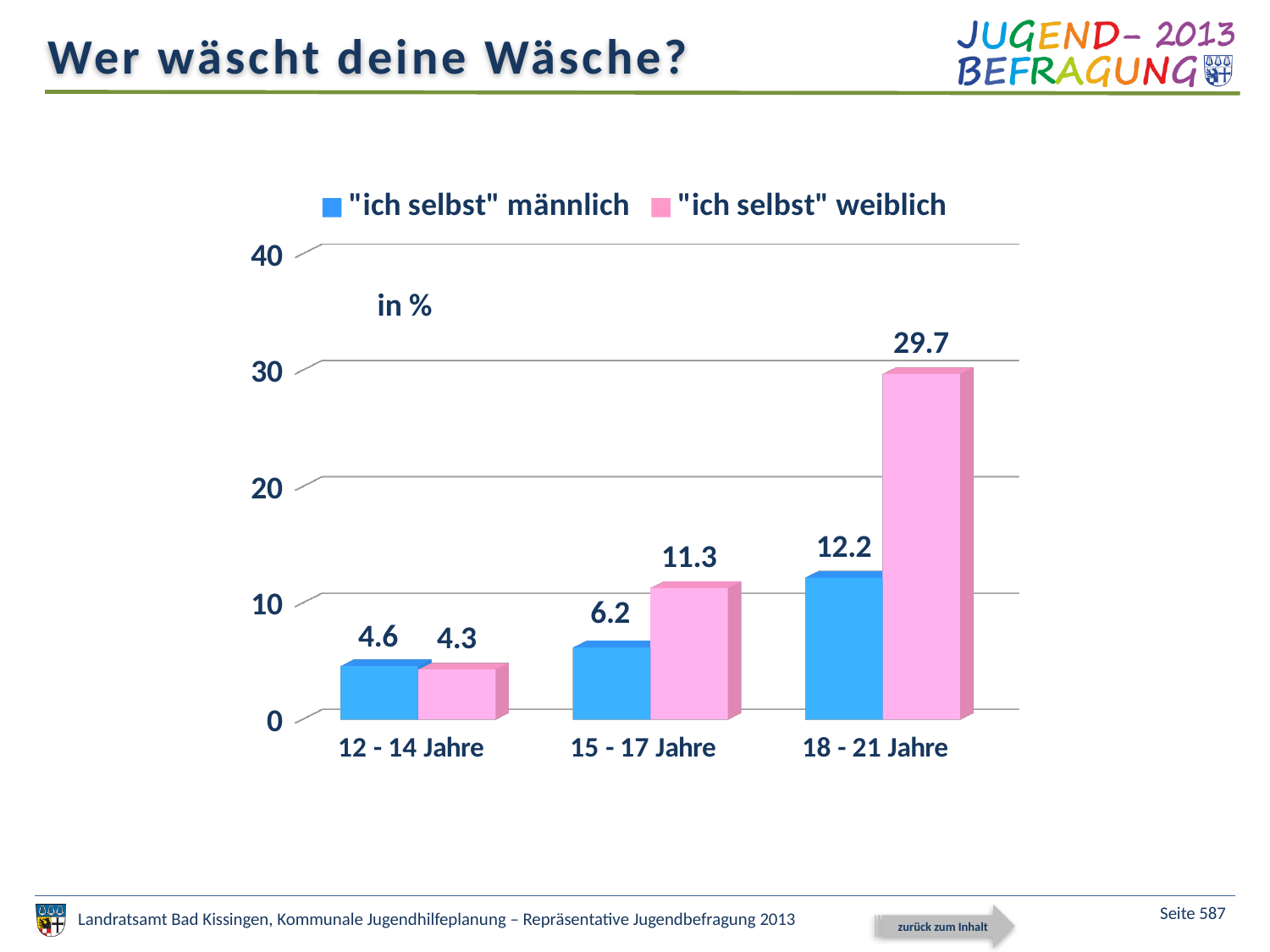
How many age groups are shown on the x axis? 3 What kind of chart is shown on the slide? bar chart How many series does the legend list? 2 Which age group has the highest value for "ich selbst" weiblich? 18 - 21 Jahre What is the value for "ich selbst" weiblich in the 15 - 17 Jahre group? 11.3 In the 15 - 17 Jahre group, which is larger: "ich selbst" männlich or "ich selbst" weiblich? "ich selbst" weiblich Which age group has the lowest value for "ich selbst" männlich? 12 - 14 Jahre What is the value for "ich selbst" weiblich in the 18 - 21 Jahre group? 29.7 Is the value for "ich selbst" männlich in the 18 - 21 Jahre group greater or less than 10? greater What is the value for "ich selbst" männlich in the 12 - 14 Jahre group? 4.6 Do the values for "ich selbst" männlich rise or fall from the 12 - 14 Jahre group to the 18 - 21 Jahre group? rise What is the difference between the "ich selbst" weiblich and "ich selbst" männlich values in the 18 - 21 Jahre group? 17.5